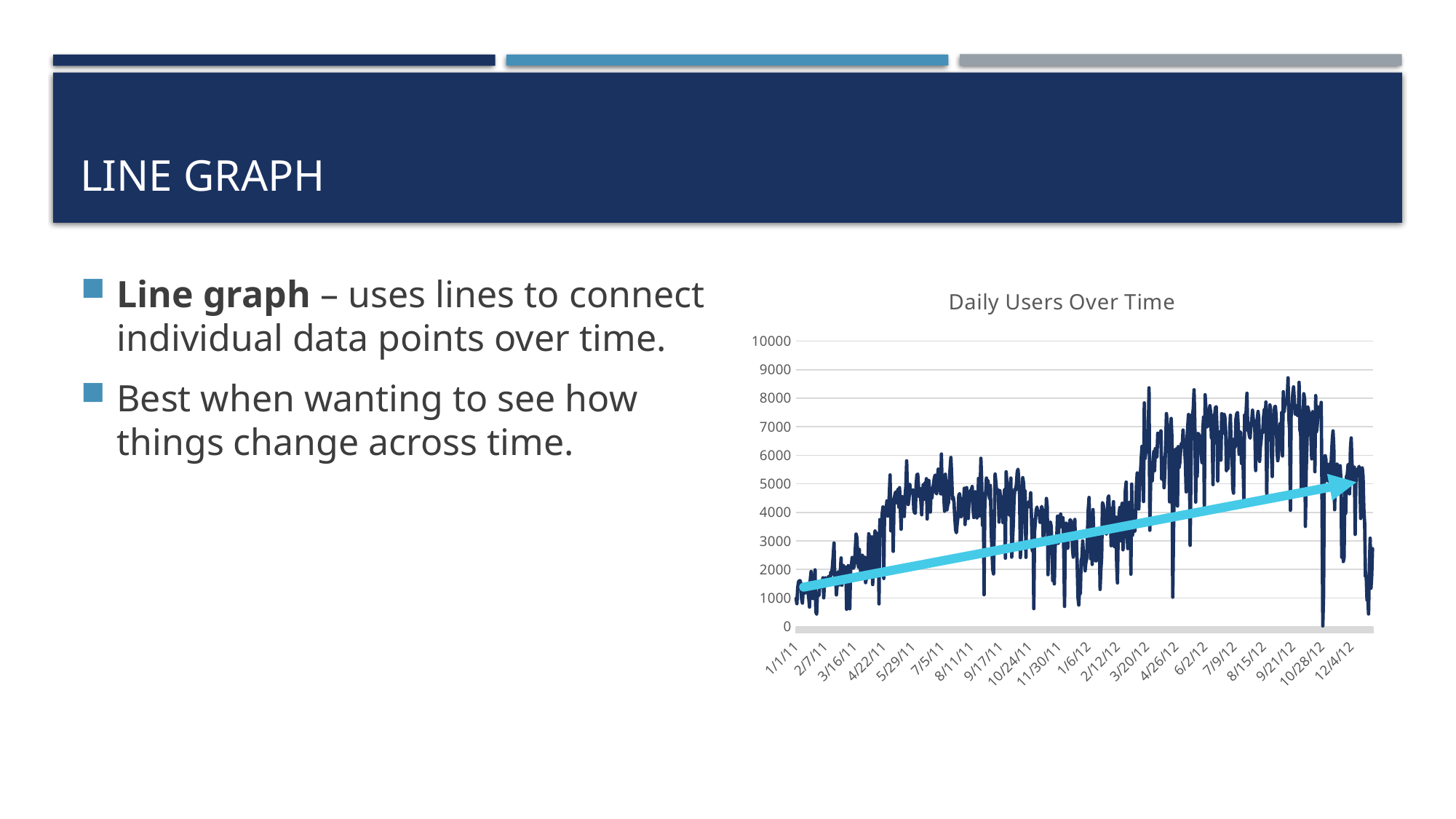
Is the value around 7/9/12 in the Daily Users Over Time chart greater or less than 5000? greater Which is higher in the Daily Users Over Time chart, the value around 6/2/12 or the value around 5/29/11? 6/2/12 Is the lowest value in the Daily Users Over Time chart greater or less than 1000? less What is the last date label on the x axis of the Daily Users Over Time chart? 12/4/12 Is the value at 1/1/11 in the Daily Users Over Time chart greater or less than 3000? less What kind of chart is shown on the slide? line chart What is the first date label on the x axis of the Daily Users Over Time chart? 1/1/11 What is the highest tick value shown on the y axis of the Daily Users Over Time chart? 10000 What is the title of the chart? Daily Users Over Time Overall, do the values in the Daily Users Over Time chart rise or fall from 1/1/11 to the end of the x axis? rise